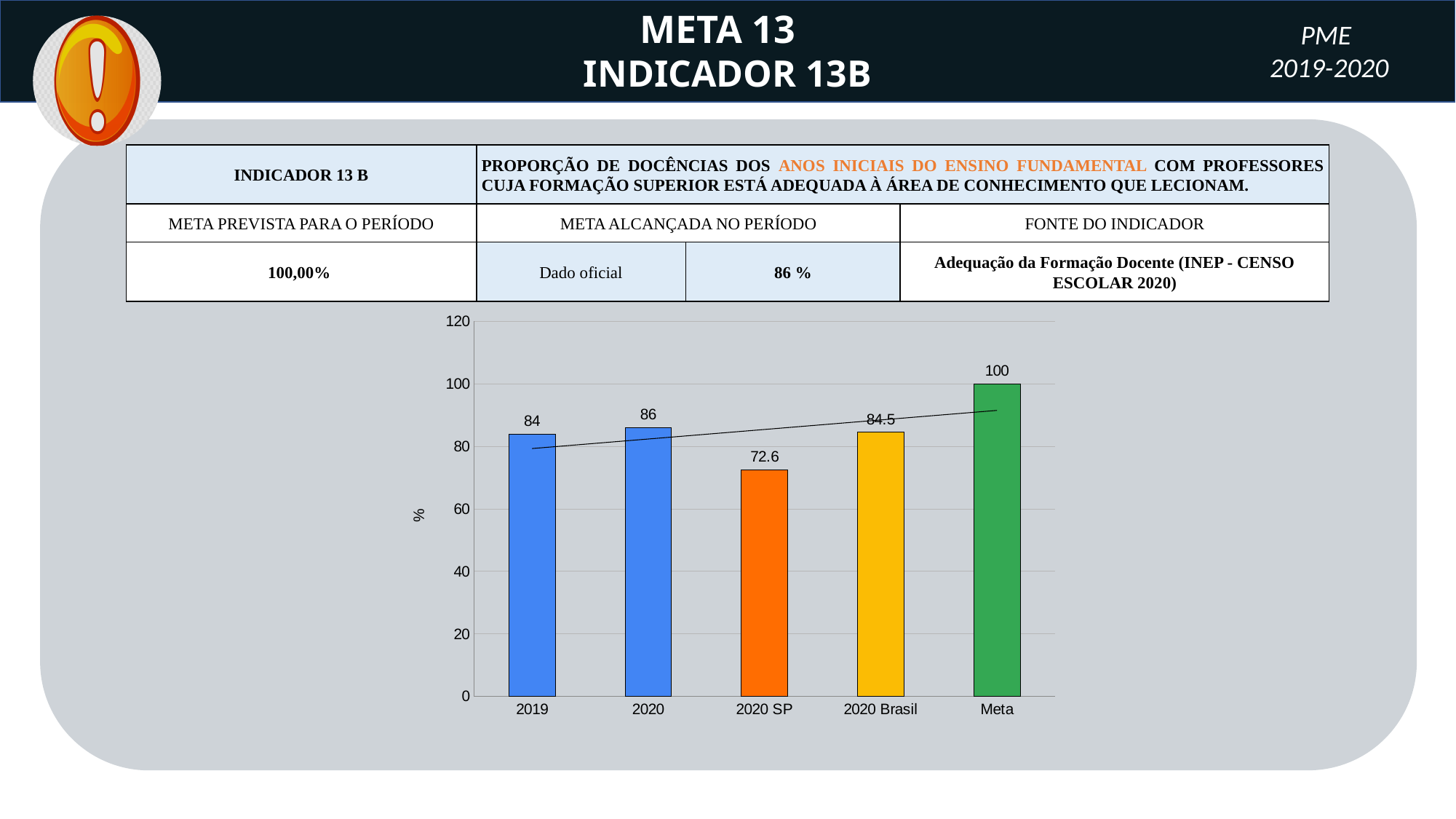
What kind of chart is shown on the slide? bar chart What is the value for Meta? 100 What is the difference between the Meta value and the 2020 value? 14 What is the difference between the 2020 value and the 2019 value? 2 How many bars are shown in the chart? 5 Which is larger, the value for 2020 or the value for 2020 SP? 2020 What is the value for 2020 Brasil? 84.5 Which category has the highest value? Meta What is the value for 2019? 84 Which category has the lowest value? 2020 SP What is the value for 2020 SP? 72.6 What is the label on the vertical axis of the chart? %